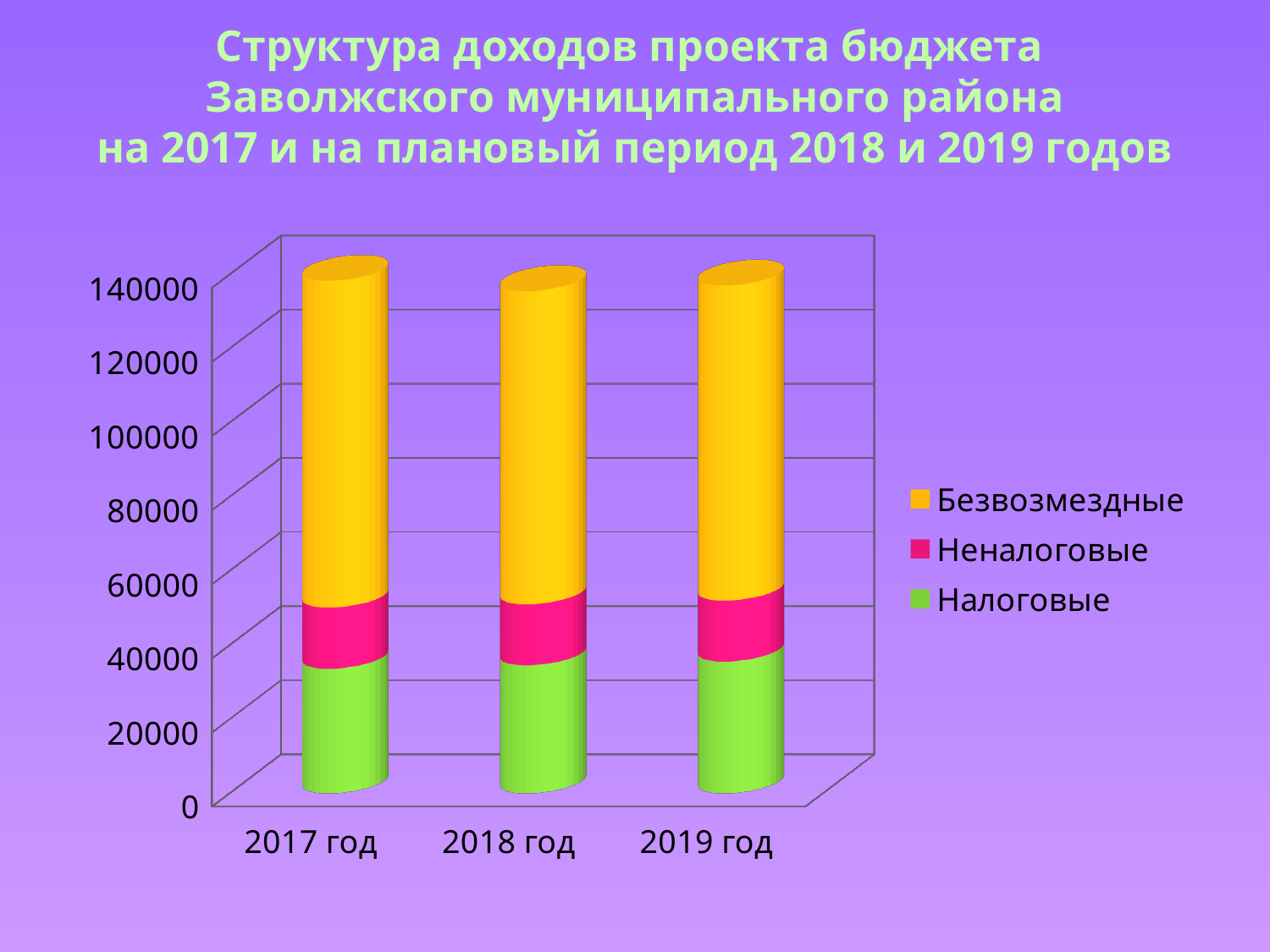
Which series forms the smallest segment of the bar for 2017 год? Неналоговые Is the total value of the bar for 2018 год greater or less than 100000? greater Which series forms the largest segment of the bar for 2019 год? Безвозмездные What kind of chart is shown on the slide? stacked bar chart Is the value of Налоговые for 2019 год greater or less than 20000? greater Is the total value of the bar for 2017 год greater or less than 120000? greater Which series is shown in green? Налоговые How many series does the legend list? 3 How many years (categories) are shown on the x axis? 3 Which series is shown in yellow? Безвозмездные